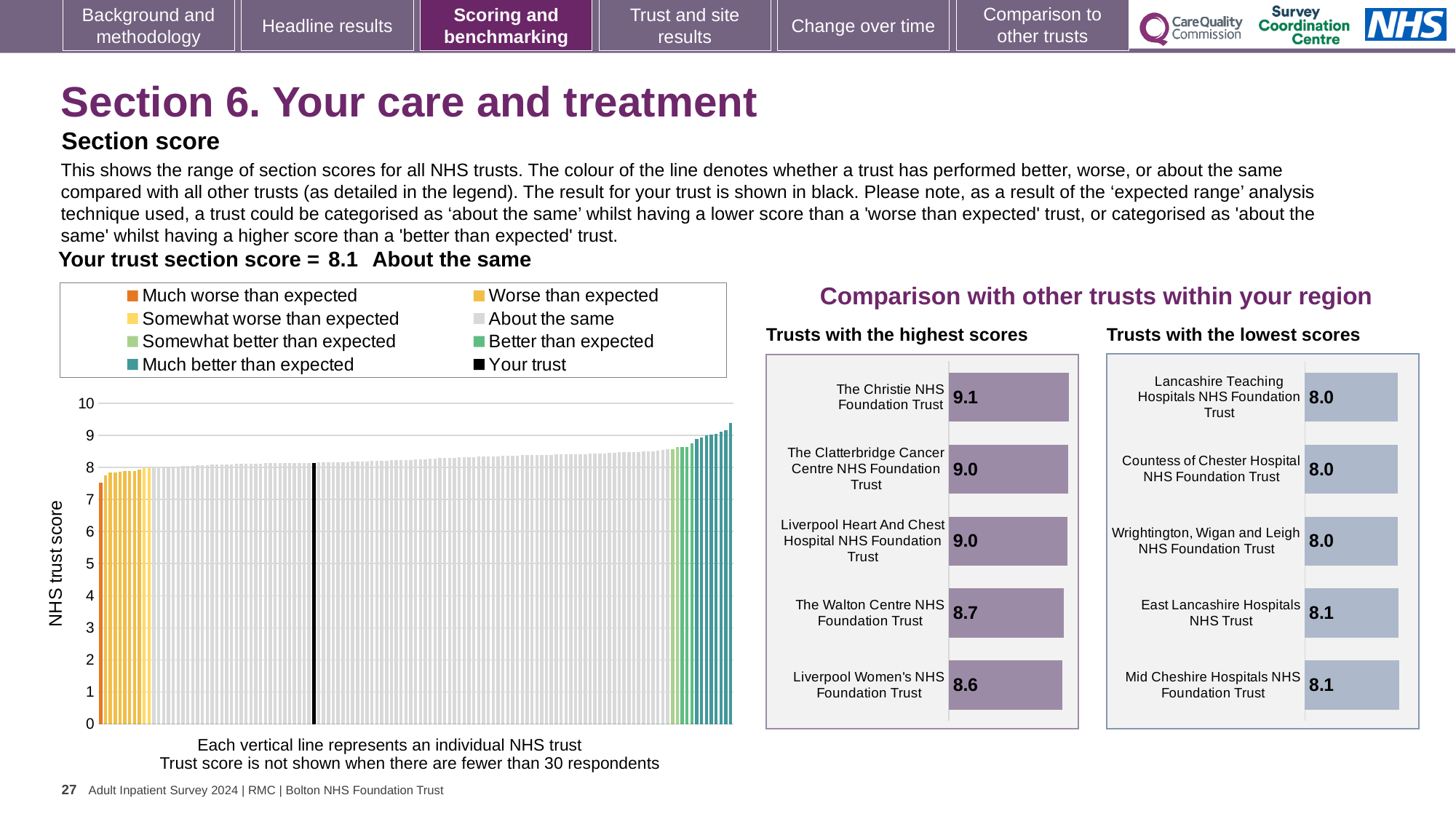
In the large chart on the left, do the trust scores rise or fall from left to right? Rise In the 'Trusts with the lowest scores' chart, what is the score for Mid Cheshire Hospitals NHS Foundation Trust? 8.1 In the 'Trusts with the lowest scores' chart, what is the difference between the scores of East Lancashire Hospitals NHS Trust and Lancashire Teaching Hospitals NHS Foundation Trust? 0.1 In the 'Trusts with the highest scores' chart, what is the score for The Walton Centre NHS Foundation Trust? 8.7 In the 'Trusts with the lowest scores' chart, what is the score for Countess of Chester Hospital NHS Foundation Trust? 8.0 How many entries does the legend of the large chart on the left list? 8 In the 'Trusts with the highest scores' chart, what is the score for The Christie NHS Foundation Trust? 9.1 In the 'Trusts with the highest scores' chart, what is the difference between the scores of The Christie NHS Foundation Trust and Liverpool Women's NHS Foundation Trust? 0.5 In the 'Trusts with the highest scores' chart, which trust has the lowest score? Liverpool Women's NHS Foundation Trust What kind of chart is the large chart on the left showing NHS trust scores? Bar chart How many trusts are shown in the 'Trusts with the highest scores' chart? 5 In the 'Trusts with the lowest scores' chart, which has the higher score: East Lancashire Hospitals NHS Trust or Wrightington, Wigan and Leigh NHS Foundation Trust? East Lancashire Hospitals NHS Trust